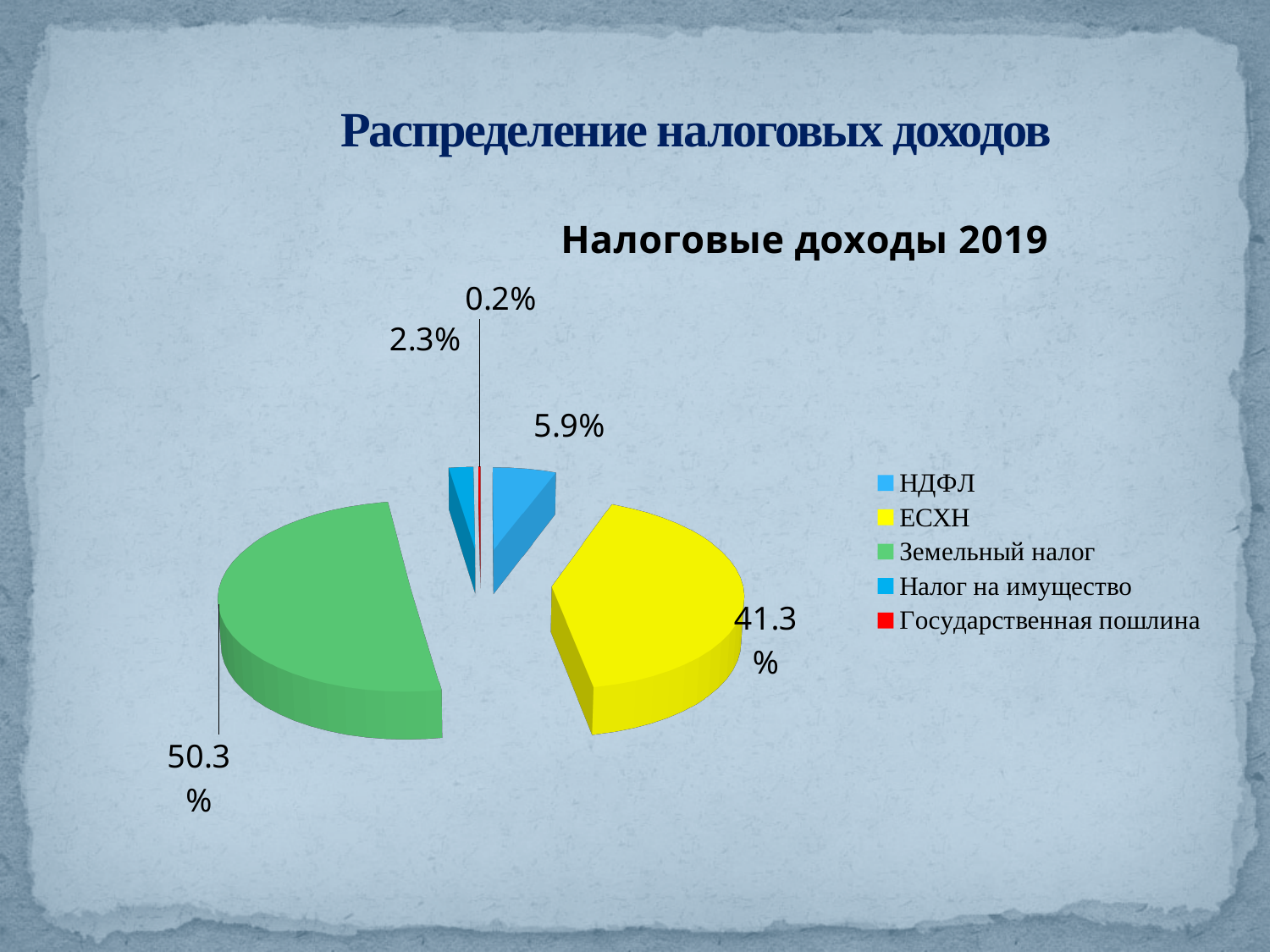
What share of the pie does Земельный налог have? 50.3% Which category has the largest slice? Земельный налог What is the title of the chart? Налоговые доходы 2019 What type of chart is shown on the slide? pie chart Which category has the smallest slice? Государственная пошлина What is the difference between the shares of Земельный налог and ЕСХН? 9.0% How many categories does the legend list? 5 Which is larger, the share of НДФЛ or the share of Налог на имущество? НДФЛ What share of the pie does Государственная пошлина have? 0.2% What share of the pie does ЕСХН have? 41.3%